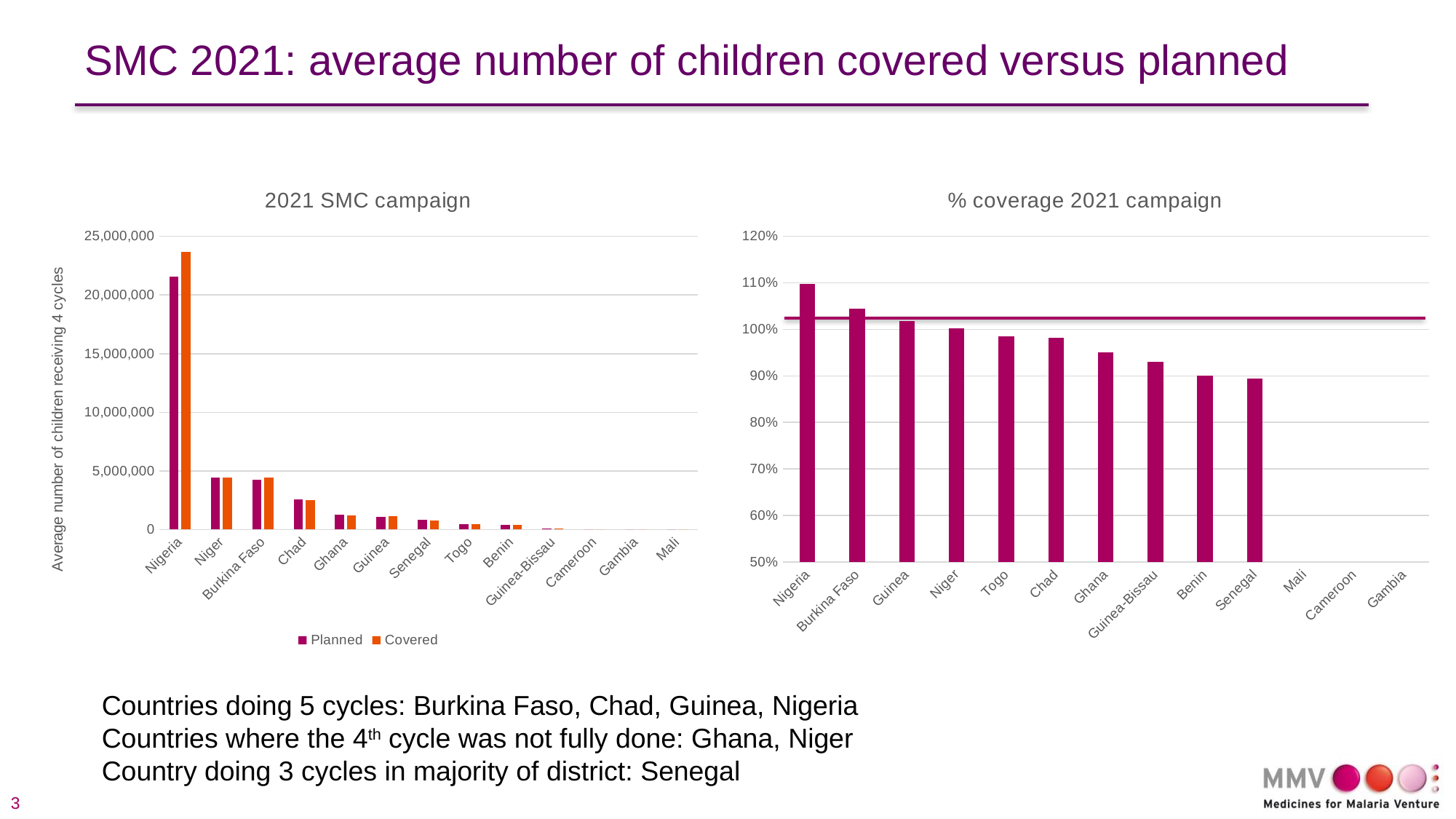
In the '2021 SMC campaign' chart, is the Covered value for Nigeria larger or smaller than its Planned value? larger In the '2021 SMC campaign' chart, which country has the highest Planned value? Nigeria In the '2021 SMC campaign' chart, is the Planned value for Niger greater or less than 5,000,000? less In the '% coverage 2021 campaign' chart, is the value for Nigeria greater or less than 100%? greater In the '% coverage 2021 campaign' chart, which country has the highest coverage? Nigeria In the '2021 SMC campaign' chart, is the Planned value for Nigeria greater or less than 20,000,000? greater What is the y-axis title of the '2021 SMC campaign' chart? Average number of children receiving 4 cycles How many series does the legend of the '2021 SMC campaign' chart list? 2 In the '2021 SMC campaign' chart, how many countries are shown on the x axis? 13 What type of chart is the '2021 SMC campaign' chart on the left? bar chart In the '% coverage 2021 campaign' chart, do the bar values rise or fall from left to right along the x axis? fall